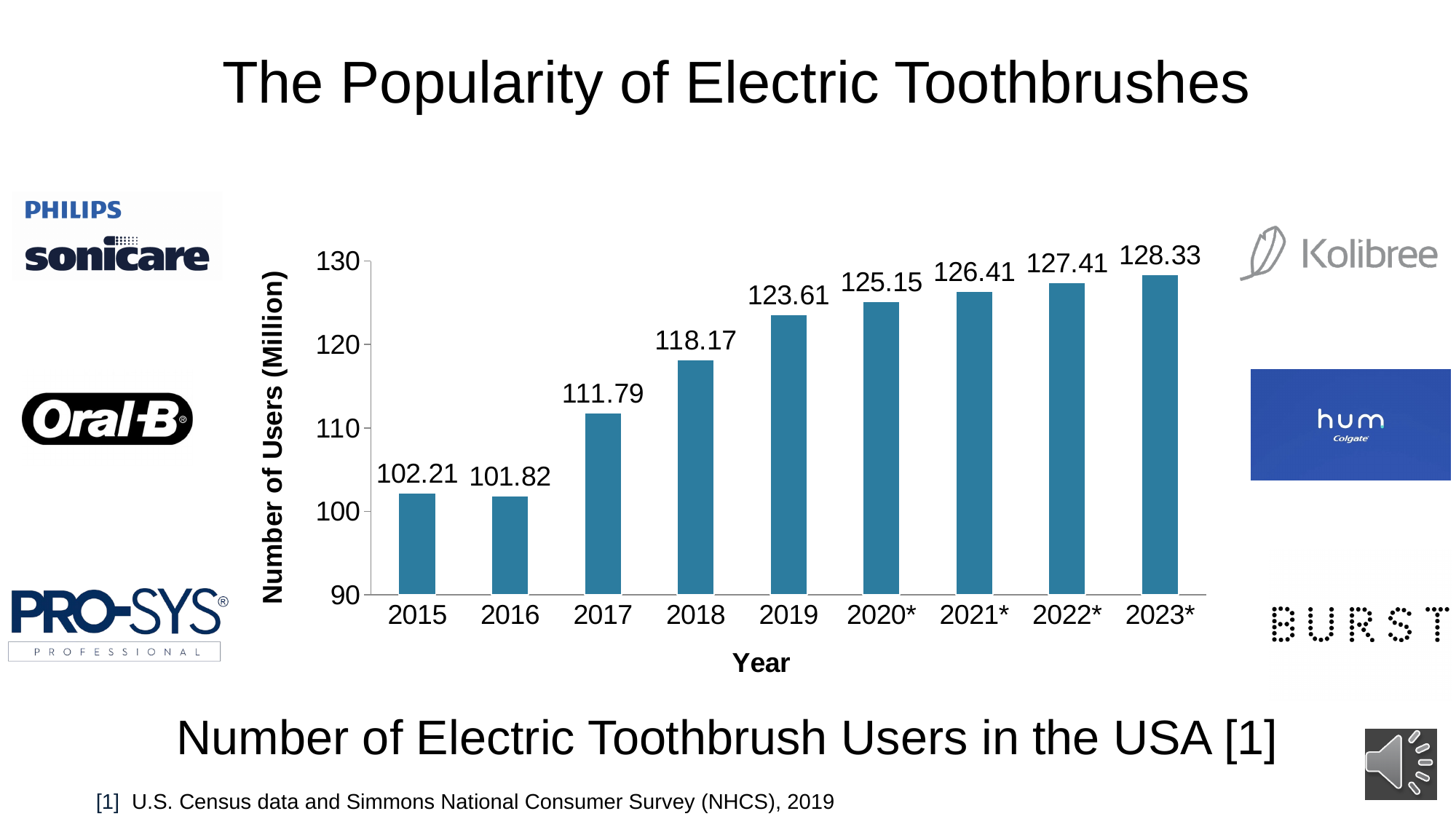
Which is larger, the value for 2015 or the value for 2016? 2015 What is the label of the y axis? Number of Users (Million) What is the difference between the values for 2018 and 2017? 6.38 What is the number of electric toothbrush users (in millions) shown for 2017? 111.79 What value is shown for 2023*? 128.33 Which year has the highest number of users? 2023* What is the number of users shown for 2019? 123.61 How many years are shown on the x axis? 9 Which year has the lowest number of users? 2016 What kind of chart is shown on the slide? bar chart Is the value for 2020* greater or less than 120? greater Do the values generally rise or fall from 2016 to 2023*? rise